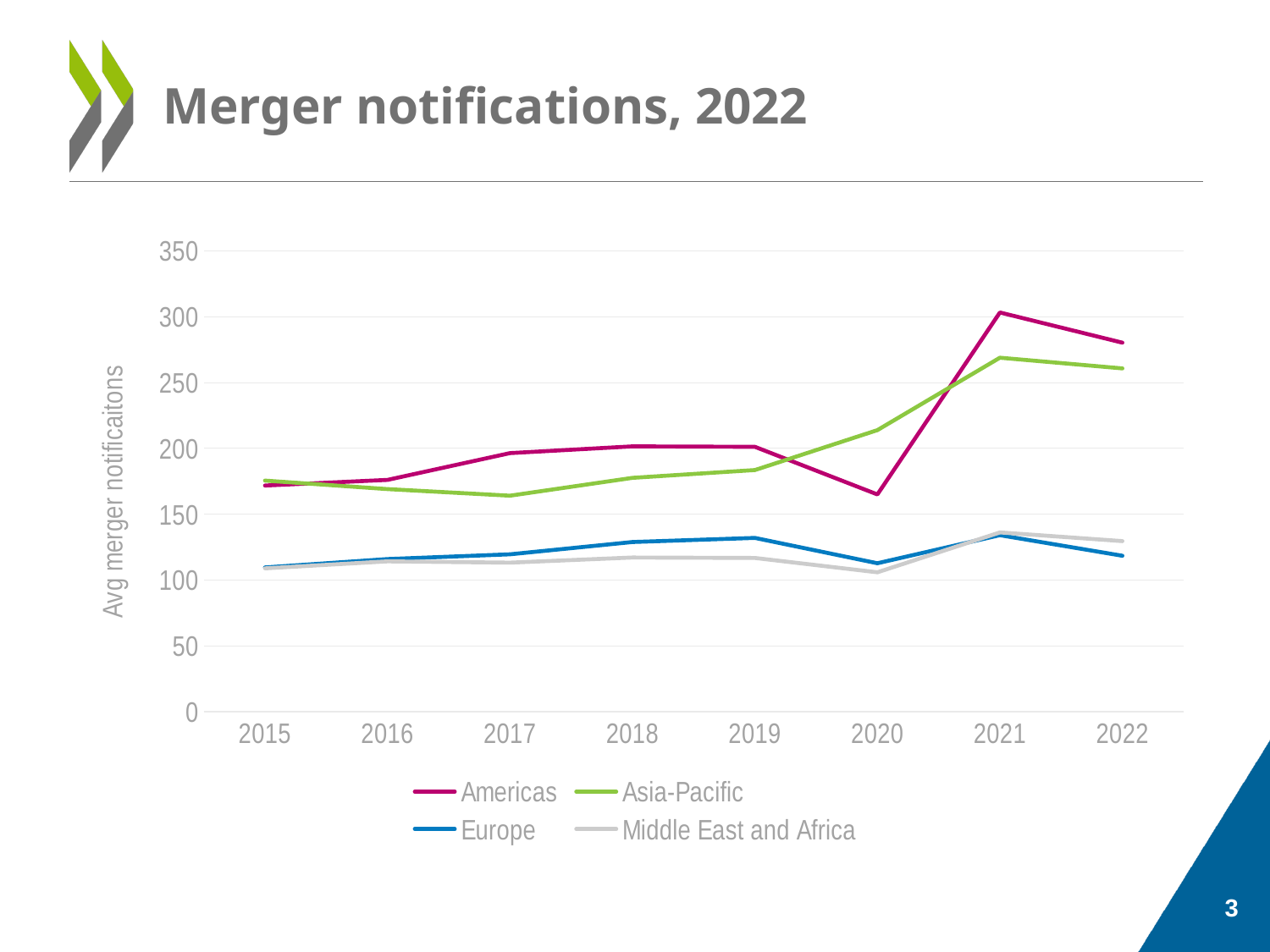
How many years are shown along the x axis? 8 Is the value for Asia-Pacific in 2020 greater or less than 200? greater What is the title of the slide containing the chart? Merger notifications, 2022 Which series has the lowest value in 2022? Europe Is the value for Americas in 2022 greater or less than 250? greater Is the value for Europe in 2015 greater or less than 150? less Which series has the highest value in 2021? Americas Does the value for Asia-Pacific rise or fall from 2019 to 2021? rise How many series does the legend list? 4 What kind of chart is shown on the slide? Line chart In 2019, which is larger: the value for Americas or the value for Asia-Pacific? Americas